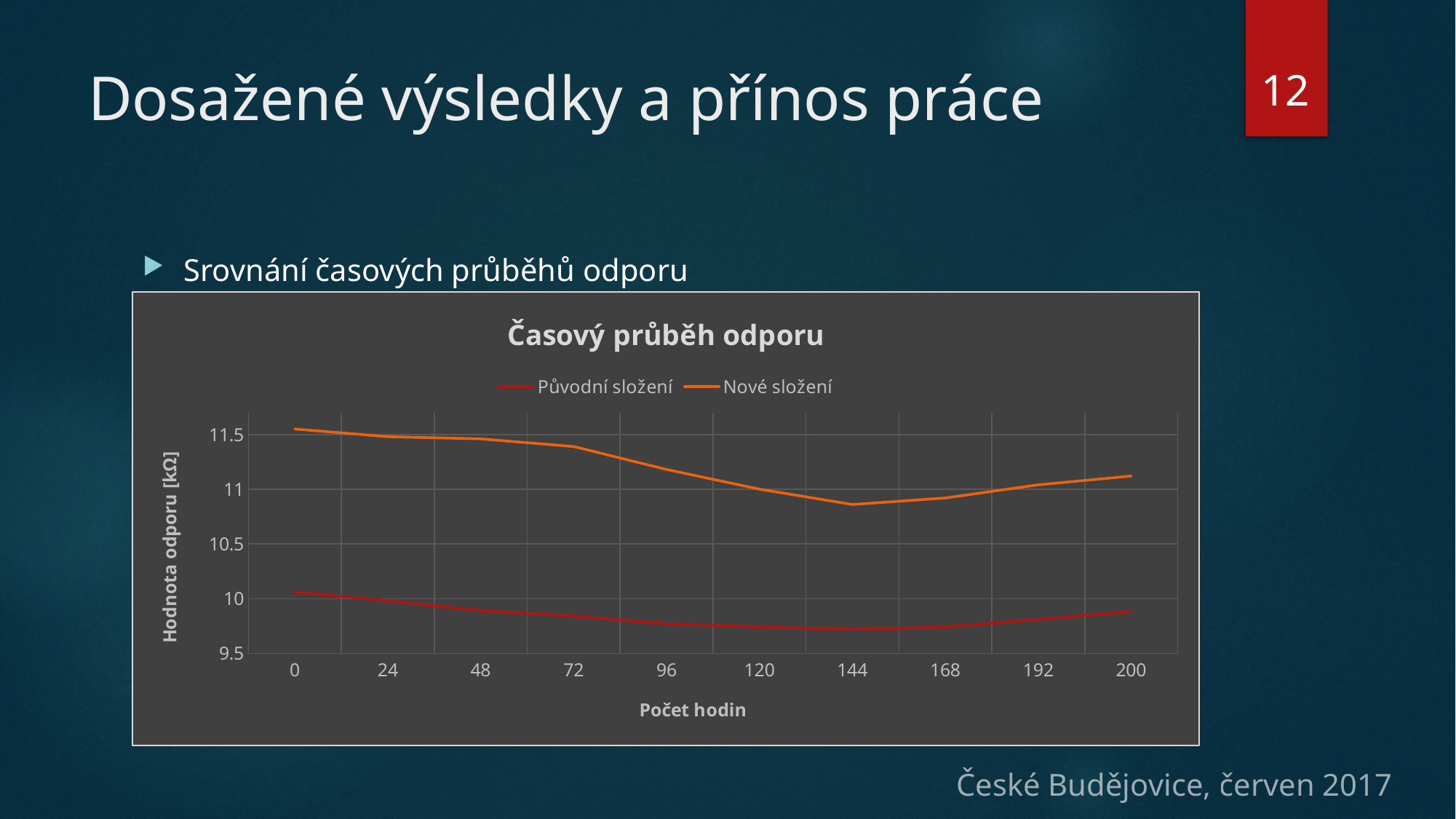
What is the title of the chart? Časový průběh odporu How many tick labels are shown on the x axis (Počet hodin)? 10 Between 0 and 144 hours, does the Nové složení series rise or fall? fall Is the value of Nové složení at 200 hours greater or less than 11? greater What kind of chart is shown on the slide? line chart Is the value of Nové složení at 144 hours greater or less than 11? less How many series does the chart legend list? 2 At 144 hours, which series has the higher resistance value, Původní složení or Nové složení? Nové složení What are the names of the two series in the legend? Původní složení and Nové složení At which number of hours does the Nové složení series reach its lowest value? 144 Is the value of Původní složení at 144 hours greater or less than 10? less